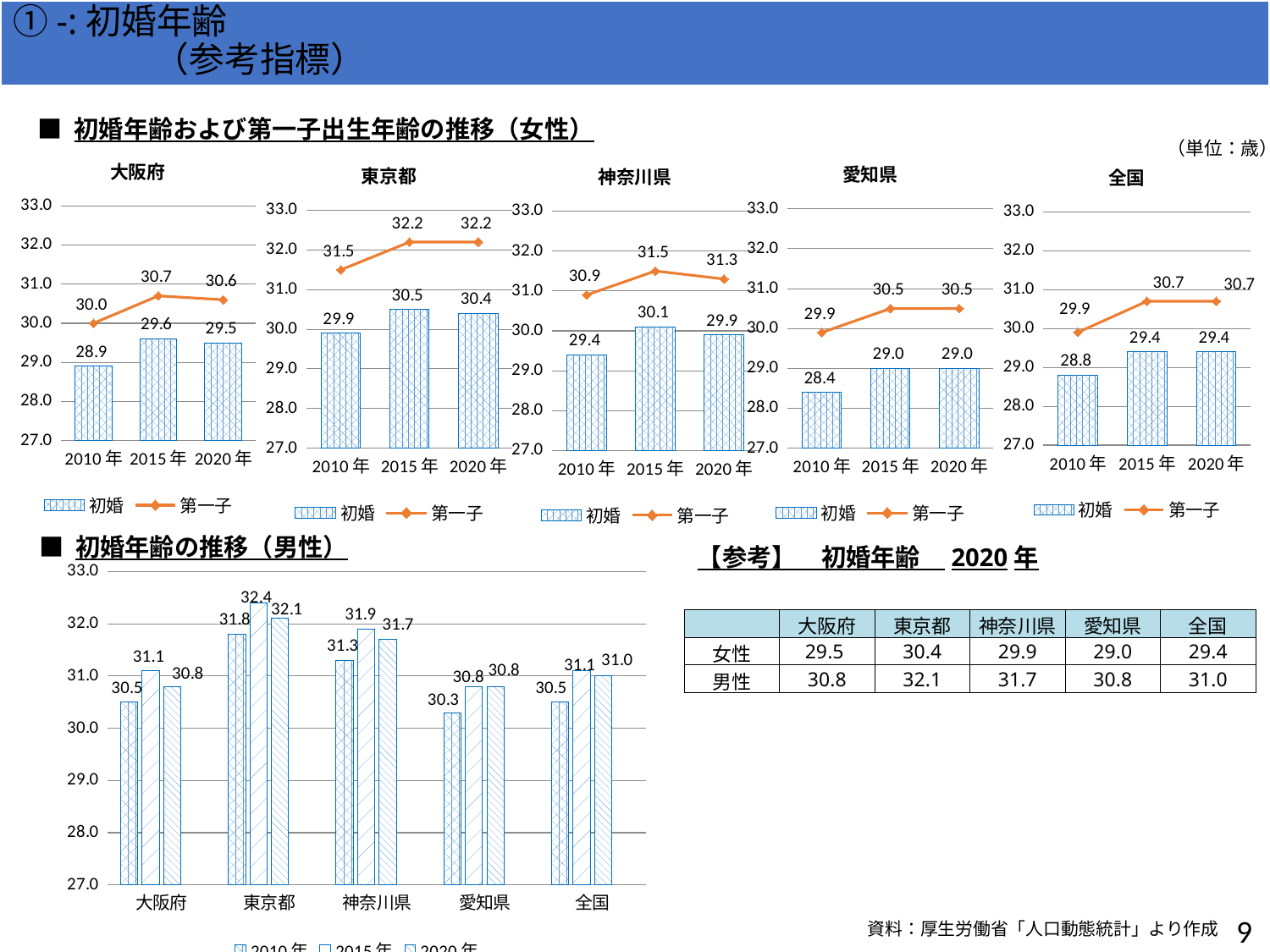
In the 全国 chart under 初婚年齢および第一子出生年齢の推移（女性）, what is the difference between the 第一子 value and the 初婚 value for 2020年? 1.3 In the 東京都 chart under 初婚年齢および第一子出生年齢の推移（女性）, how many series does the legend list? 2 In the 東京都 chart under 初婚年齢および第一子出生年齢の推移（女性）, what is the 第一子 value for 2010年? 31.5 In the 愛知県 chart under 初婚年齢および第一子出生年齢の推移（女性）, which year has the lowest 初婚 value? 2010年 In the 初婚年齢の推移（男性） chart, which prefecture has the lowest bar overall? 愛知県 In the 初婚年齢の推移（男性） chart, which is larger: the middle bar for 神奈川県 or the middle bar for 大阪府? 神奈川県 In the 大阪府 chart under 初婚年齢および第一子出生年齢の推移（女性）, what is the 初婚 value for 2015年? 29.6 In the 初婚年齢の推移（男性） chart, how many categories are shown on the x axis? 5 In the 神奈川県 chart under 初婚年齢および第一子出生年齢の推移（女性）, which year has the highest 初婚 value? 2015年 In the 初婚年齢の推移（男性） chart, what is the value of the tallest bar for 東京都? 32.4 In the 大阪府 chart under 初婚年齢および第一子出生年齢の推移（女性）, does the 第一子 value rise or fall from 2010年 to 2015年? rise What kind of chart is the 初婚年齢の推移（男性） chart? bar chart